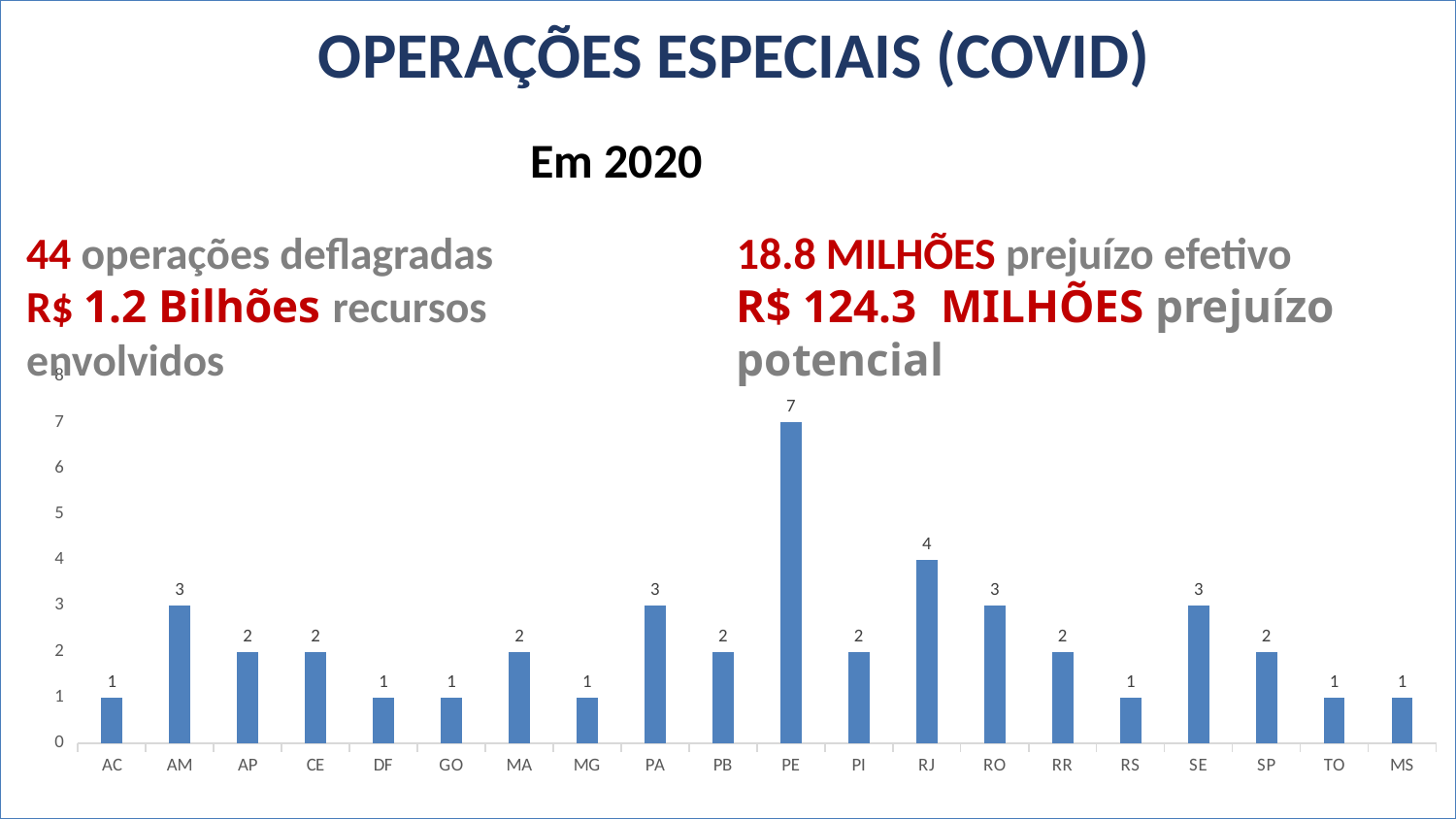
What type of chart is shown on the slide? bar chart Which is larger, the value for PA or the value for PB? PA How many categories are shown on the x axis? 20 What is the value for PE? 7 What is the value for AM? 3 Which is larger, the value for SE or the value for SP? SE What is the difference between the values for PE and RJ? 3 What is the value for RJ? 4 What is the value for MS? 1 Which category has the highest value? PE Is the value for PE greater or less than 5? greater What is the difference between the values for RO and DF? 2